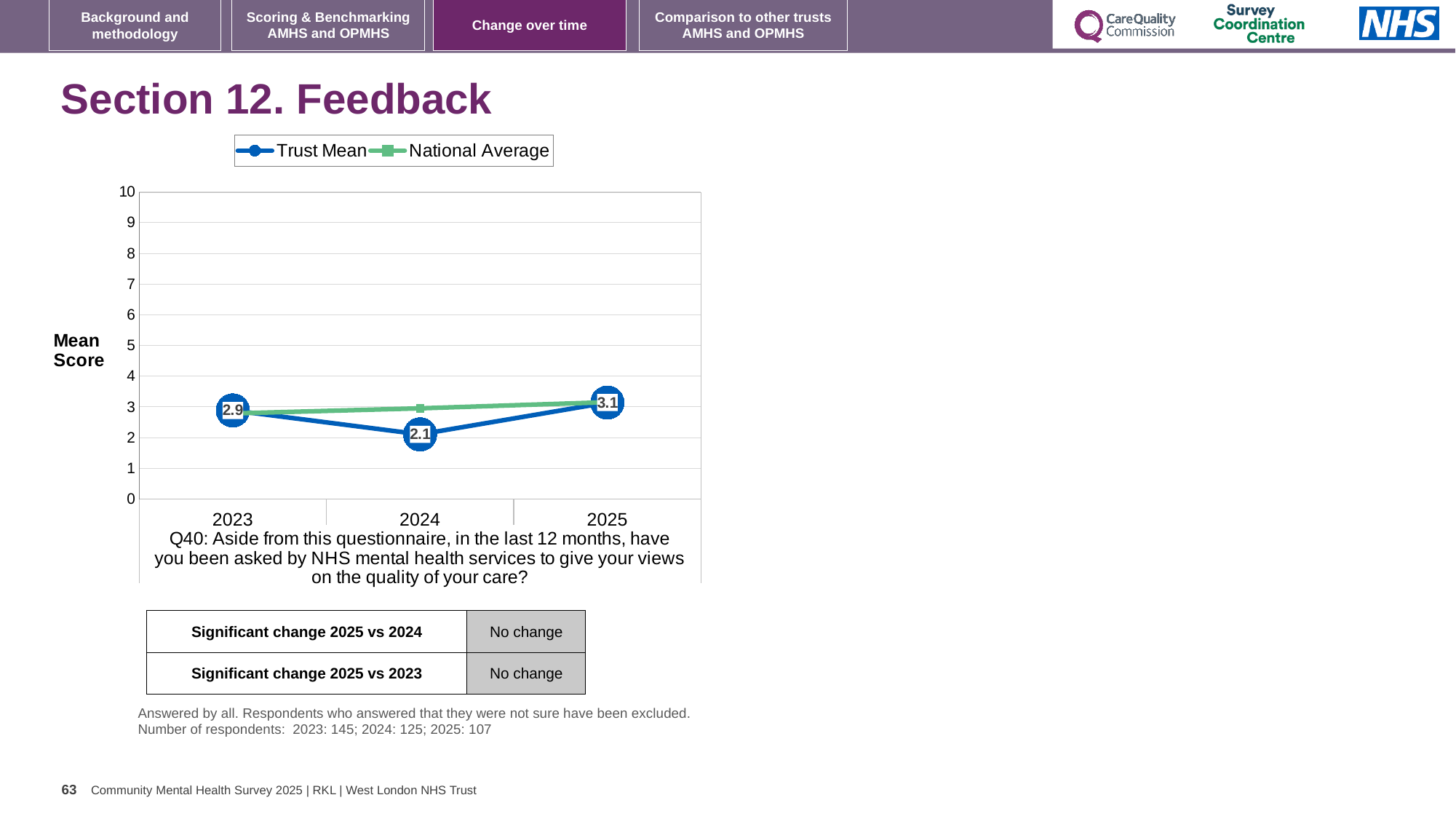
Does the Trust Mean rise or fall from 2024 to 2025? rise What is the Trust Mean score for 2025? 3.1 Which is larger in 2024, the Trust Mean or the National Average? National Average How many years are shown on the x axis of the chart? 3 In which year is the Trust Mean score lowest? 2024 What is the difference between the Trust Mean scores for 2025 and 2024? 1.0 In which year is the Trust Mean score highest? 2025 What is the Trust Mean score for 2024? 2.1 What is the Trust Mean score for 2023? 2.9 Is the National Average value for 2023 greater or less than 2? greater What kind of chart is shown on the slide? line chart How many series does the chart legend list? 2